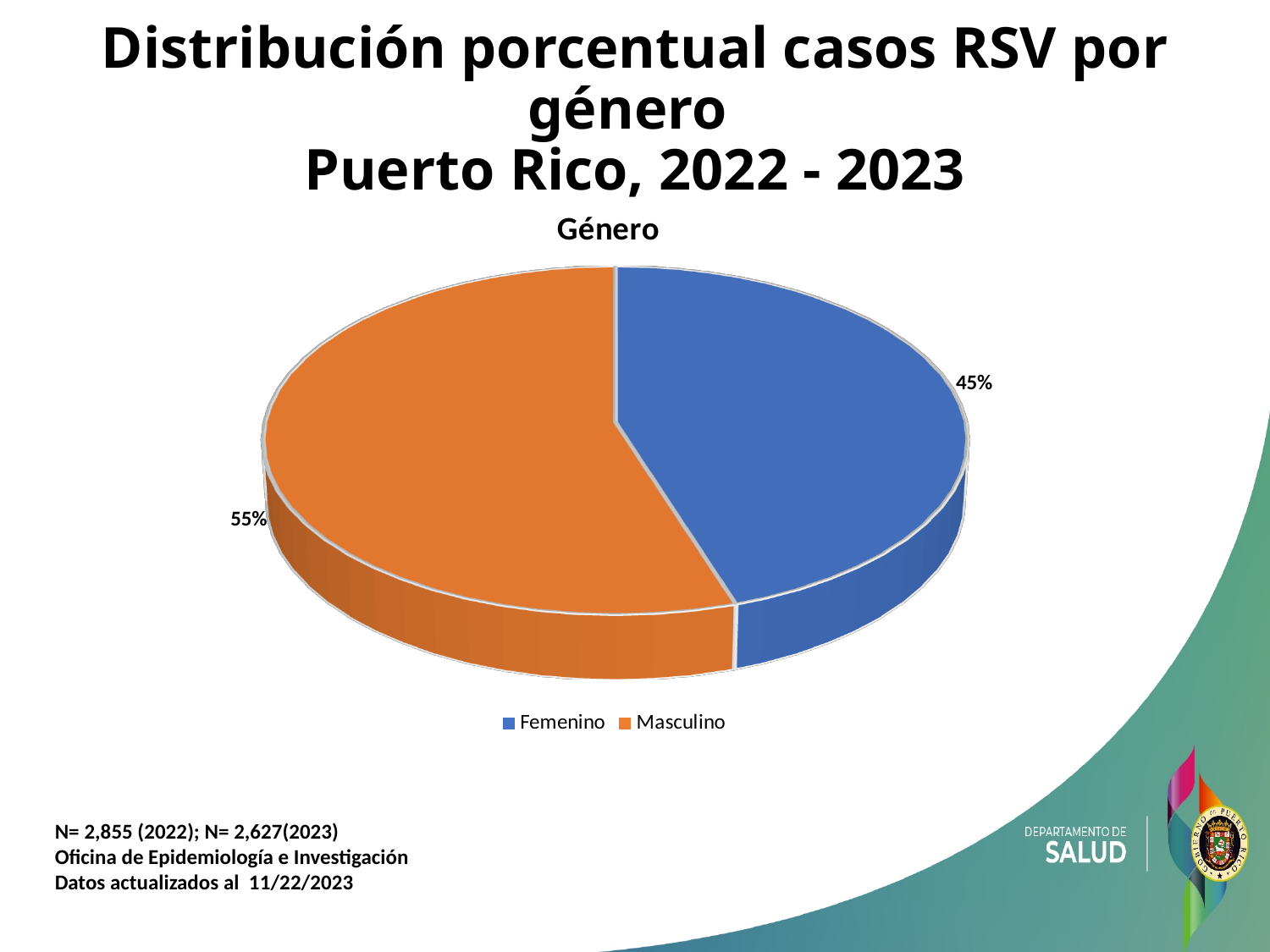
Which gender has the smaller share of RSV cases? Femenino How many entries does the legend list? 2 Which gender has the larger share of RSV cases? Masculino What percentage of RSV cases are Masculino? 55% What percentage of RSV cases are Femenino? 45% Which colour represents Femenino in the pie chart? blue How many slices does the pie chart have? 2 Is the share for Masculino larger or smaller than the share for Femenino? larger What is the title shown directly above the pie chart? Género What kind of chart is shown on the slide? pie chart Is the share for Femenino greater or less than 50%? less What is the difference in percentage points between the Masculino and Femenino shares? 10%